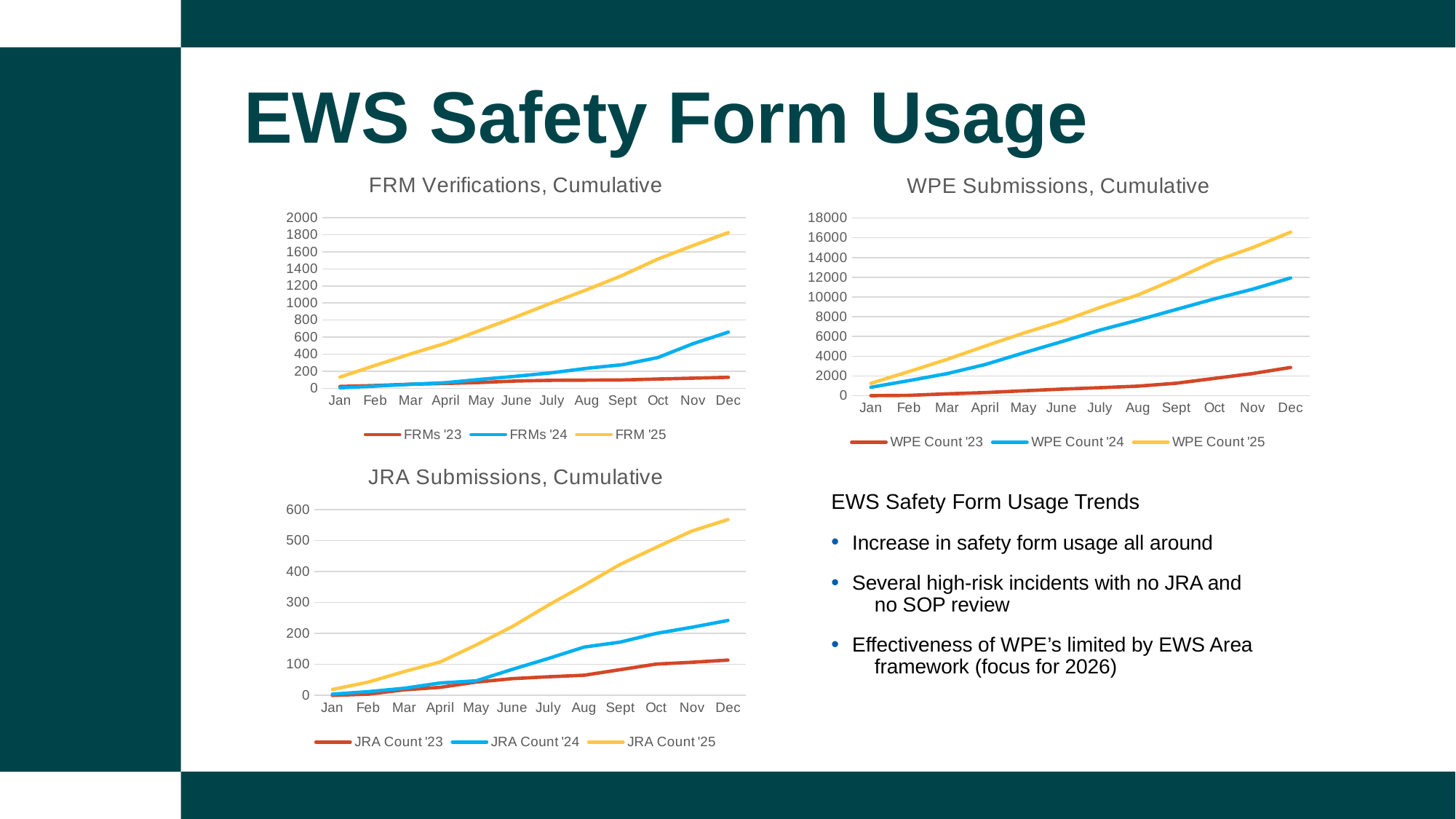
In the "JRA Submissions, Cumulative" chart, is the value for JRA Count '25 in Dec greater or less than 500? greater In the "JRA Submissions, Cumulative" chart, which is larger in Dec: JRA Count '24 or JRA Count '23? JRA Count '24 In the "WPE Submissions, Cumulative" chart, which series is lowest in Dec? WPE Count '23 What kind of chart is the "FRM Verifications, Cumulative" chart? line chart How many months are plotted along the x axis of the "JRA Submissions, Cumulative" chart? 12 In the "FRM Verifications, Cumulative" chart, is the value for FRM '25 in Dec greater or less than 1600? greater In the "FRM Verifications, Cumulative" chart, is the value for FRMs '23 in Dec greater or less than 200? less What is the title of the chart in the bottom-left of the slide? JRA Submissions, Cumulative In the "WPE Submissions, Cumulative" chart, do the values for WPE Count '24 rise or fall from Jan to Dec? rise How many series does the legend of the "WPE Submissions, Cumulative" chart list? 3 In the "FRM Verifications, Cumulative" chart, which series is highest in Dec? FRM '25